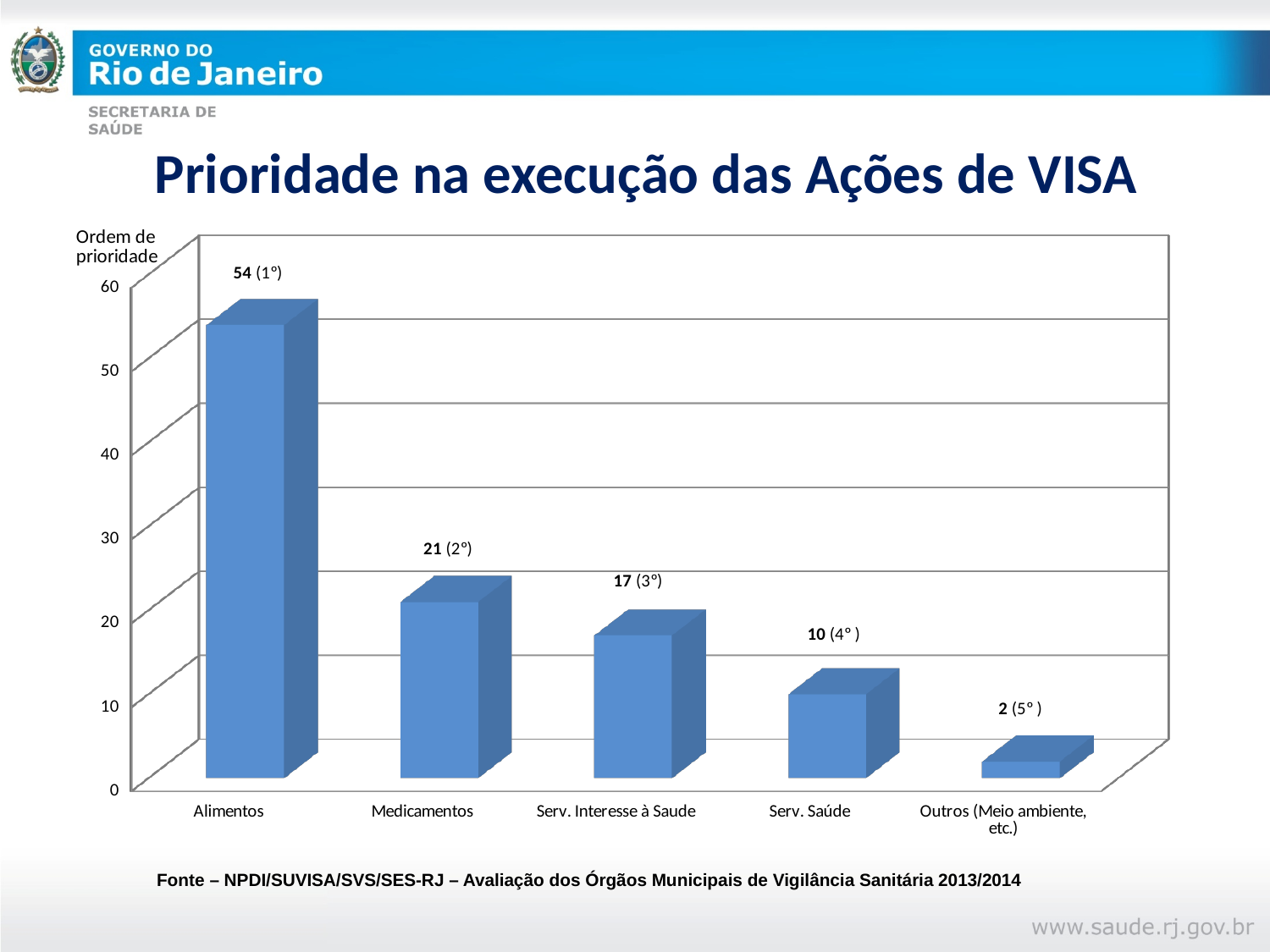
What is the value for Outros (Meio ambiente, etc.)? 2 Which category has the lowest value? Outros (Meio ambiente, etc.) Which category has the highest value? Alimentos Which is larger, the value for Medicamentos or the value for Serv. Saúde? Medicamentos What kind of chart is shown on the slide? Bar chart What is the value for Serv. Interesse à Saude? 17 What is the value for Alimentos? 54 What is the value for Serv. Saúde? 10 What is the title of the chart? Prioridade na execução das Ações de VISA What is the value for Medicamentos? 21 What is the difference between the values for Alimentos and Medicamentos? 33 How many categories are shown on the chart? 5